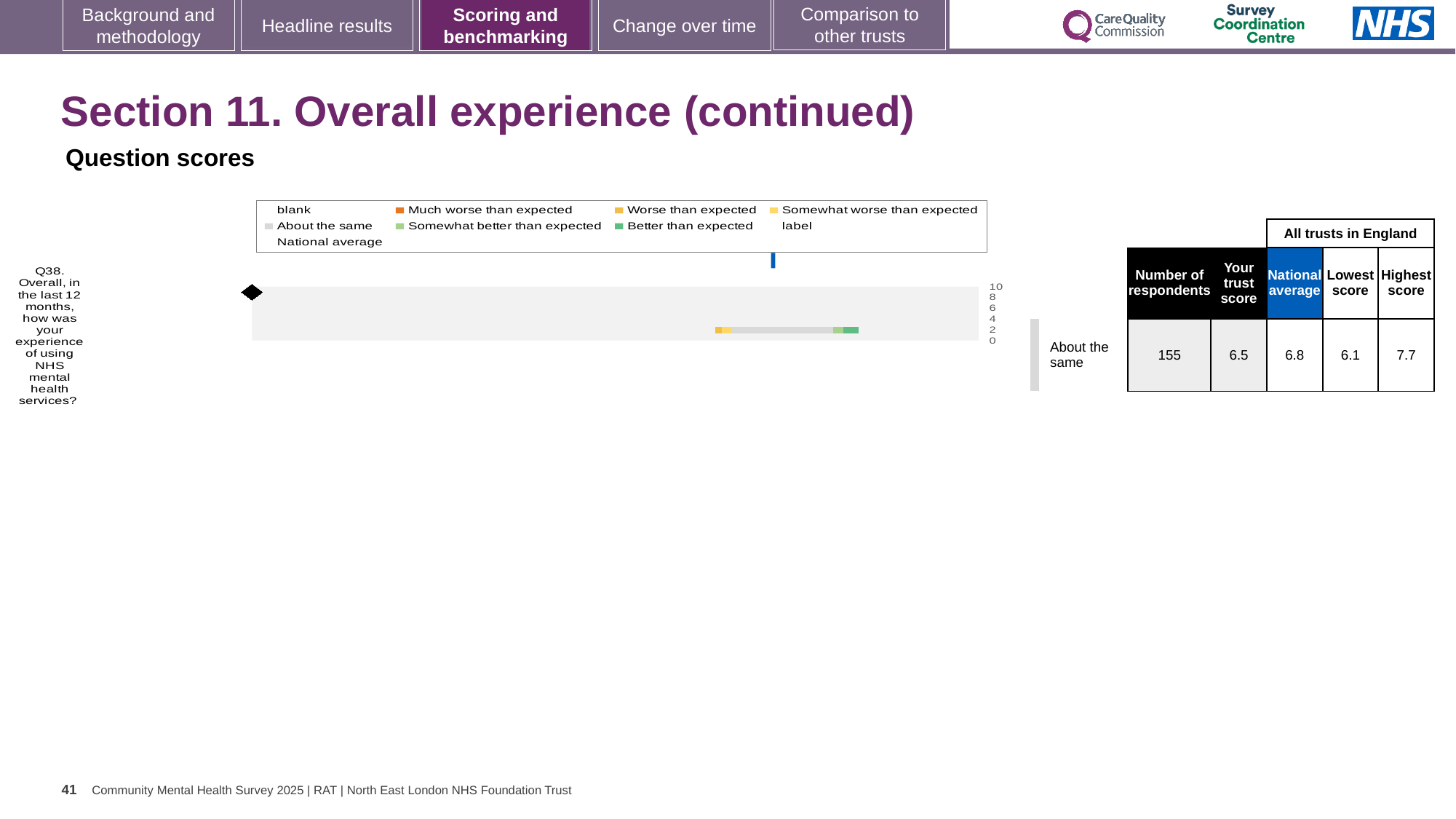
Which is larger for Q38, the trust score or the national average? national average What is the difference between the national average and the trust score for Q38? 0.3 According to the table, how many respondents answered Q38? 155 According to the table, what is the trust score for Q38? 6.5 According to the table, what is the national average for Q38? 6.8 Which colour does the legend use for 'Much worse than expected'? orange How many questions (categories) are plotted in the chart? 1 According to the table, what is the highest score among all trusts in England for Q38? 7.7 According to the table, what is the lowest score among all trusts in England for Q38? 6.1 What kind of chart is shown for Q38 on this slide? bar chart What is the difference between the highest and lowest scores among all trusts in England for Q38? 1.6 What is the highest tick value shown on the chart's axis? 10